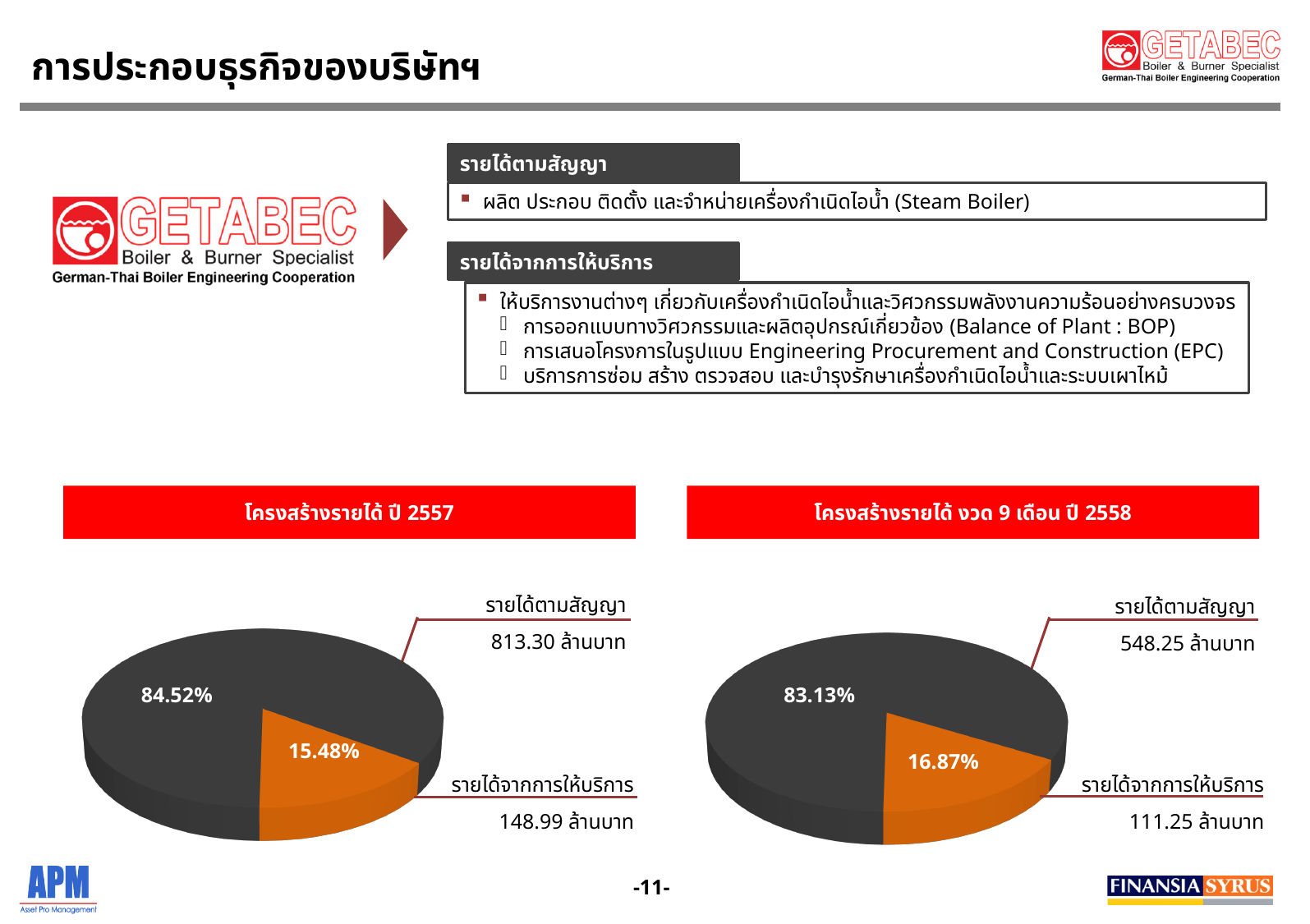
In the 'โครงสร้างรายได้ ปี 2557' chart, what share of the pie does รายได้จากการให้บริการ represent? 15.48% In the 'โครงสร้างรายได้ งวด 9 เดือน ปี 2558' chart, what is the value for รายได้ตามสัญญา? 548.25 ล้านบาท How many slices does the 'โครงสร้างรายได้ งวด 9 เดือน ปี 2558' pie chart have? 2 In the 'โครงสร้างรายได้ งวด 9 เดือน ปี 2558' chart, what share of the pie does รายได้ตามสัญญา represent? 83.13% In the 'โครงสร้างรายได้ งวด 9 เดือน ปี 2558' chart, what is the value for รายได้จากการให้บริการ? 111.25 ล้านบาท In the 'โครงสร้างรายได้ ปี 2557' chart, which category is the largest? รายได้ตามสัญญา What type of chart is used in the 'โครงสร้างรายได้ ปี 2557' chart? Pie chart In the 'โครงสร้างรายได้ ปี 2557' chart, what is the difference between รายได้ตามสัญญา and รายได้จากการให้บริการ? 664.31 ล้านบาท In the 'โครงสร้างรายได้ ปี 2557' chart, what is the value for รายได้จากการให้บริการ? 148.99 ล้านบาท In the 'โครงสร้างรายได้ ปี 2557' chart, what is the value for รายได้ตามสัญญา? 813.30 ล้านบาท Which is larger: รายได้จากการให้บริการ in the 'โครงสร้างรายได้ ปี 2557' chart or รายได้จากการให้บริการ in the 'โครงสร้างรายได้ งวด 9 เดือน ปี 2558' chart? โครงสร้างรายได้ ปี 2557 In the 'โครงสร้างรายได้ งวด 9 เดือน ปี 2558' chart, which category is the smallest? รายได้จากการให้บริการ